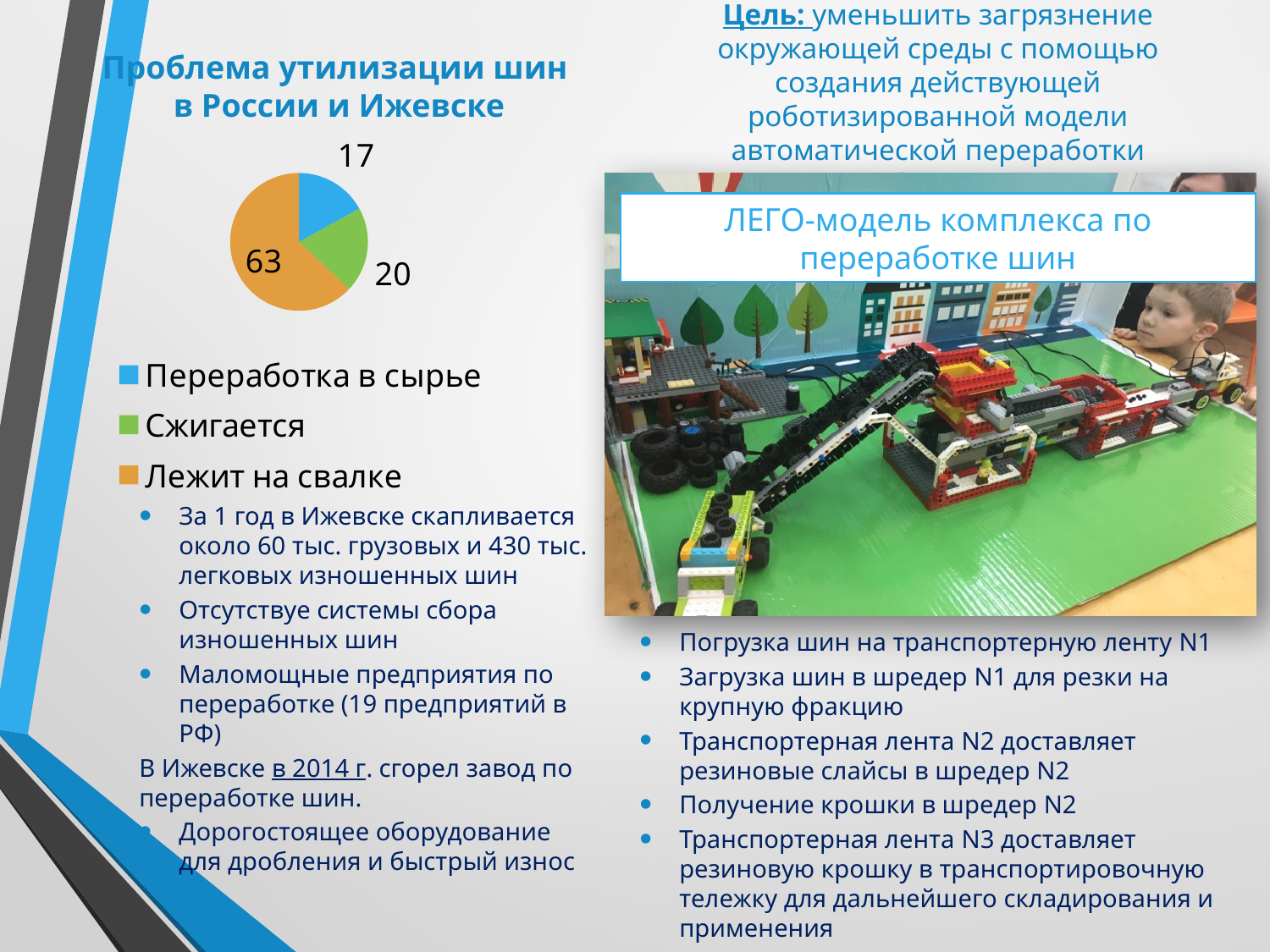
Which category has the smallest slice in the pie chart? Переработка в сырье What kind of chart is shown on the slide? Pie chart What is the difference between the values for "Лежит на свалке" and "Сжигается"? 43 What is the value for "Лежит на свалке" in the pie chart? 63 What share of the pie does "Лежит на свалке" represent? 63% Which is larger in the pie chart: "Сжигается" or "Переработка в сырье"? Сжигается What is the value for "Переработка в сырье" in the pie chart? 17 What is the value for "Сжигается" in the pie chart? 20 What colour is the "Сжигается" slice in the pie chart? Green How many slices does the pie chart have? 3 How many entries does the pie chart legend list? 3 Which category has the largest slice in the pie chart? Лежит на свалке